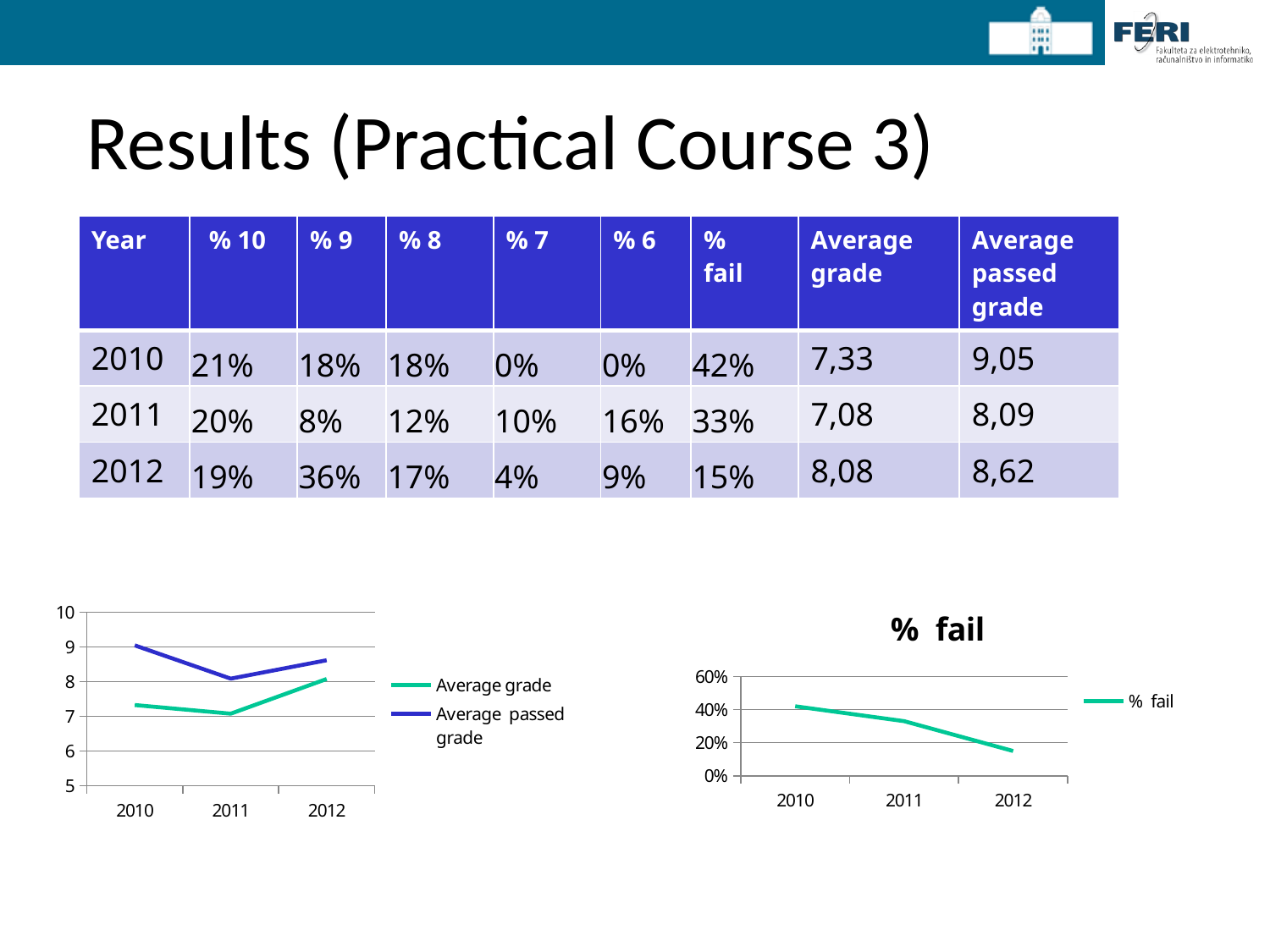
How many years are shown on the x axis of the left chart? 3 What is the title of the chart on the right of the slide? % fail In the '% fail' chart, do the values rise or fall from 2010 to 2012? fall What kind of chart is the chart on the left of the slide? line chart In the left chart, is the value for Average grade in 2011 greater or less than 8? less How many series does the legend of the left chart list? 2 In the '% fail' chart, which year has the highest value? 2010 In the left chart, which year has the highest Average grade? 2012 In the '% fail' chart, is the value for 2012 greater or less than 20%? less In the left chart, which series is higher in 2012, Average grade or Average passed grade? Average passed grade In the left chart, is the value for Average passed grade in 2010 greater or less than 8? greater In the left chart, which year has the lowest Average passed grade? 2011